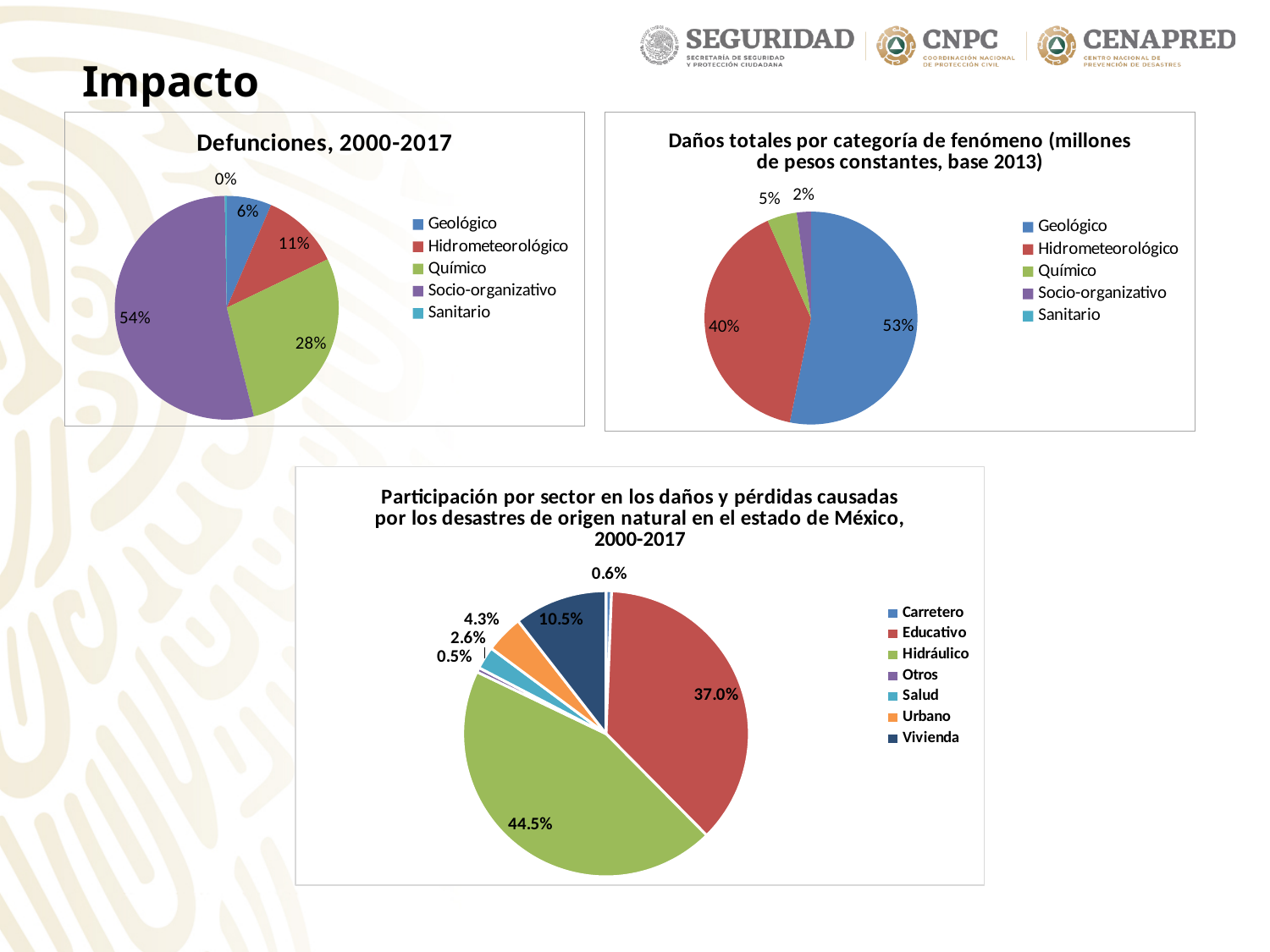
What type of chart is the 'Participación por sector' chart at the bottom of the slide? Pie chart In the 'Daños totales por categoría de fenómeno' chart, what share corresponds to Geológico? 53% How many series does the legend of the 'Daños totales por categoría de fenómeno' chart list? 5 In the 'Participación por sector' chart, what is the difference between the Hidráulico and Educativo shares? 7.5% In the 'Participación por sector' chart, what share corresponds to Hidráulico? 44.5% In the 'Daños totales por categoría de fenómeno' chart, what share corresponds to Químico? 5% In the 'Defunciones, 2000-2017' chart, which category has the largest share? Socio-organizativo In the 'Defunciones, 2000-2017' chart, what is the difference between the Hidrometeorológico and Geológico shares? 5% In the 'Daños totales por categoría de fenómeno' chart, which is larger, Geológico or Hidrometeorológico? Geológico In the 'Participación por sector' chart, which sector has the smallest share? Otros